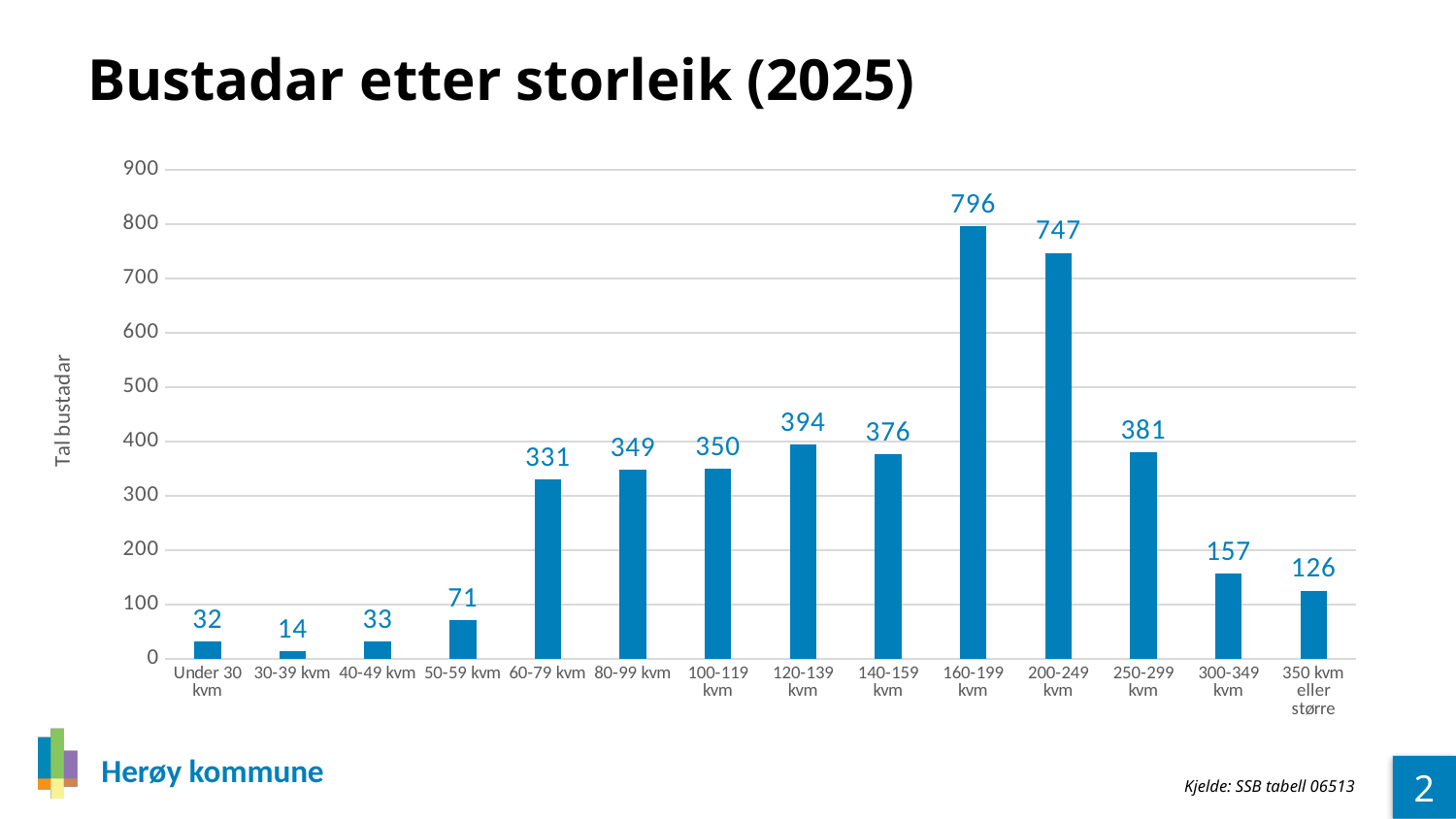
What is the label of the y axis? Tal bustadar Which category has the lowest value? 30-39 kvm How many categories are shown on the x axis? 14 What kind of chart is shown on the slide? bar chart What is the value for 160-199 kvm? 796 What is the title of the chart? Bustadar etter storleik (2025) Which is larger, the value for 120-139 kvm or the value for 140-159 kvm? 120-139 kvm Is the value for 250-299 kvm greater or less than 300? greater What is the value for 350 kvm eller større? 126 What is the value for 50-59 kvm? 71 Which category has the highest value? 160-199 kvm What is the difference between the values for 160-199 kvm and 200-249 kvm? 49